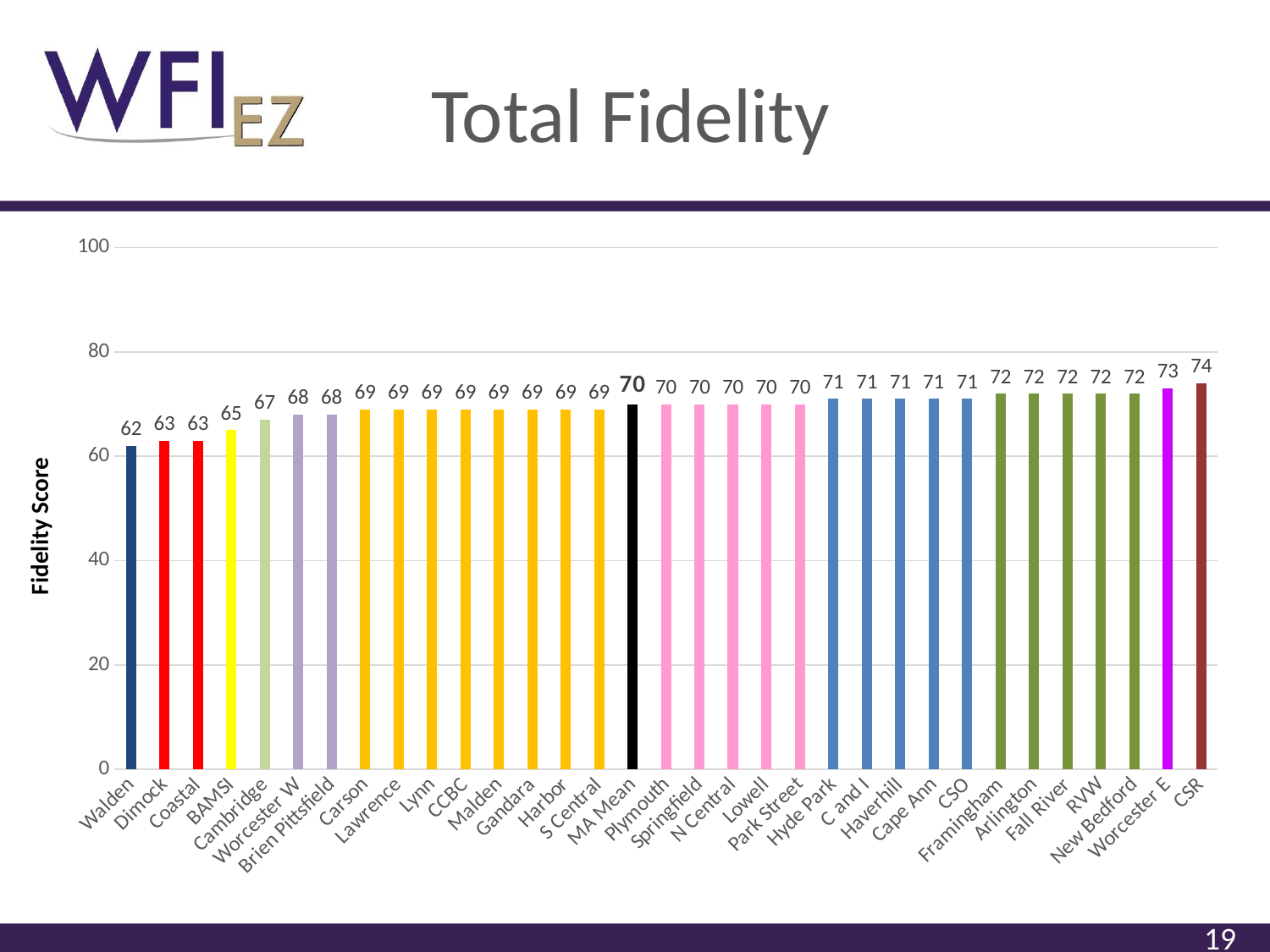
How many bars are plotted in the chart? 33 Which site has the highest fidelity score? CSR What is the fidelity score for Cambridge? 67 What type of chart is shown on the slide? Bar chart Which site has the lowest fidelity score? Walden What is the fidelity score for CSR? 74 What is the value shown for MA Mean? 70 Is the value for Dimock greater or less than 80? less Which has a higher fidelity score, Worcester E or BAMSI? Worcester E What is the label on the vertical axis? Fidelity Score What is the difference between the fidelity scores of CSR and Walden? 12 What is the fidelity score for Walden? 62